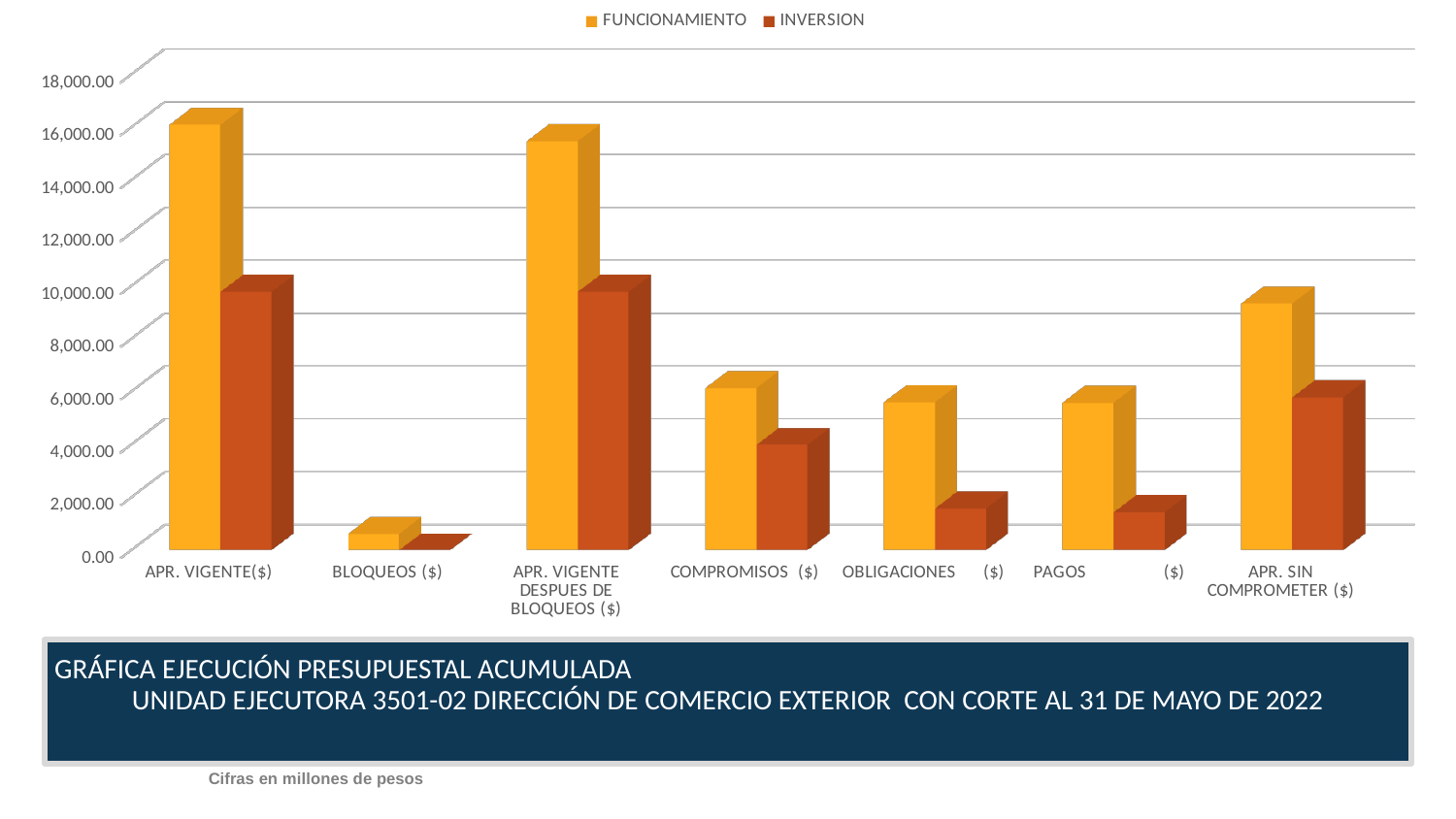
Which category has the lowest INVERSION value? BLOQUEOS ($) Is the FUNCIONAMIENTO value for APR. VIGENTE($) greater or less than 14,000.00? greater Is the INVERSION value for OBLIGACIONES ($) greater or less than 2,000.00? less How many categories are shown along the x axis? 7 What kind of chart is shown on the slide? bar chart Is the FUNCIONAMIENTO value for APR. SIN COMPROMETER ($) greater or less than 8,000.00? greater Which is larger for the INVERSION series: COMPROMISOS ($) or PAGOS ($)? COMPROMISOS ($) For APR. VIGENTE($), which series has the larger value, FUNCIONAMIENTO or INVERSION? FUNCIONAMIENTO How many series does the legend list? 2 What are the two series named in the legend? FUNCIONAMIENTO and INVERSION Which category has the highest FUNCIONAMIENTO value? APR. VIGENTE($)